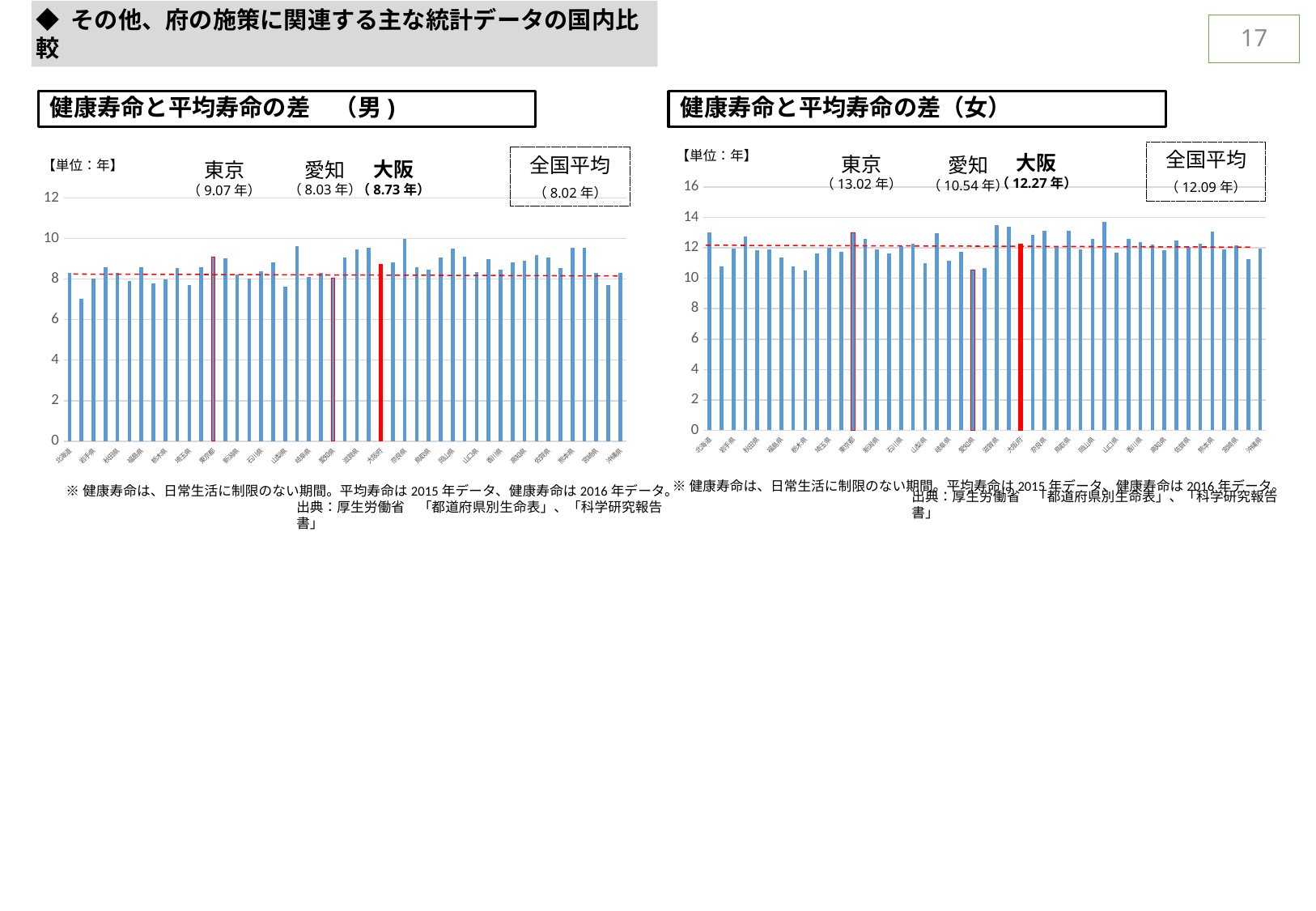
In the left chart (健康寿命と平均寿命の差（男）), how much higher is 大阪 than the 全国平均? 0.71年 What kind of chart is used for 健康寿命と平均寿命の差（男）? bar chart In the right chart (健康寿命と平均寿命の差（女）), what is the difference between 大阪 and 愛知? 1.73年 In the right chart (健康寿命と平均寿命の差（女）), what is the value for 大阪? 12.27年 In the left chart (健康寿命と平均寿命の差（男）), which is larger, 東京 or 愛知? 東京 In the left chart (健康寿命と平均寿命の差（男）), what is the 全国平均 value? 8.02年 In the left chart (健康寿命と平均寿命の差（男）), what is the value for 大阪? 8.73年 In the right chart (健康寿命と平均寿命の差（女）), what is the value for 愛知? 10.54年 In the left chart (健康寿命と平均寿命の差（男）), what is the value for 東京? 9.07年 In the right chart (健康寿命と平均寿命の差（女）), what is the 全国平均 value? 12.09年 In the right chart (健康寿命と平均寿命の差（女）), what colour is the bar for 大阪府? red